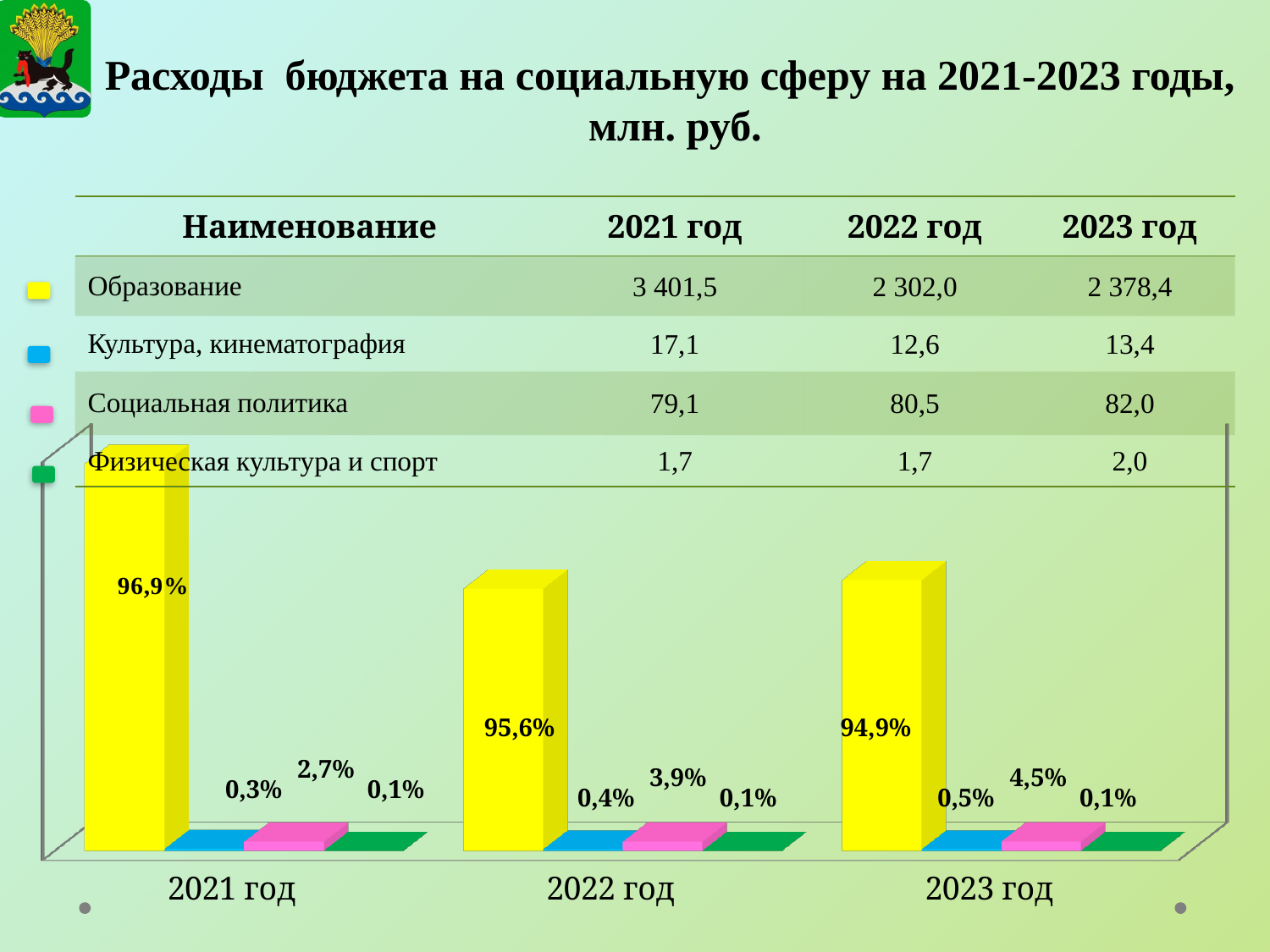
What is the data label on the green bar (Физическая культура и спорт) for 2021 год? 0,1% What is the data label on the yellow bar (Образование) for 2021 год? 96,9% In which year is the pink bar (Социальная политика) share the lowest? 2021 год In which year is the yellow bar (Образование) share the highest? 2021 год What is the data label on the pink bar (Социальная политика) for 2022 год? 3,9% What is the data label on the yellow bar (Образование) for 2023 год? 94,9% What is the data label on the blue bar (Культура, кинематография) for 2023 год? 0,5% How many year categories are shown on the x axis of the chart? 3 Does the Образование share rise or fall from 2021 год to 2023 год? fall What is the difference between the Образование share in 2021 год (96,9%) and in 2023 год (94,9%)? 2,0% What kind of chart is shown on the slide? bar chart Which is larger: the Социальная политика share in 2023 год or in 2022 год? 2023 год